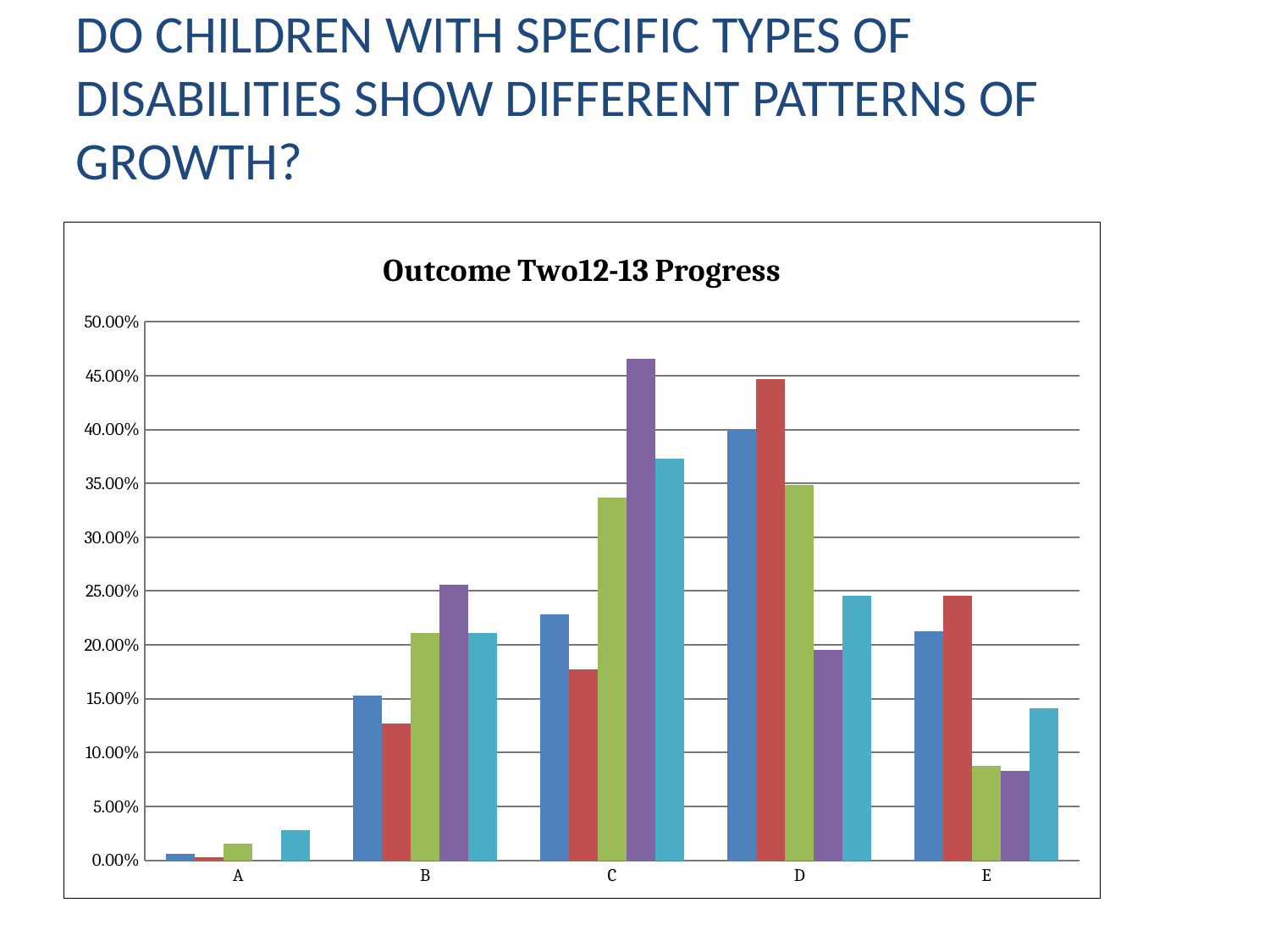
Is the value of the teal bar for E greater or less than 15.00%? less Which category has the lowest values overall? A How many bars are plotted for category B? 5 Which category has the tallest red bar? D Is the value of the purple bar for C greater or less than 45.00%? greater Which category has the tallest purple bar? C What is the title of the chart? Outcome Two12-13 Progress For category E, which is larger: the red bar or the green bar? red What type of chart is shown on the slide? bar chart Is the value of the green bar for C greater or less than 30.00%? greater For category B, which is larger: the purple bar or the red bar? purple How many categories are shown on the x axis of the chart? 5